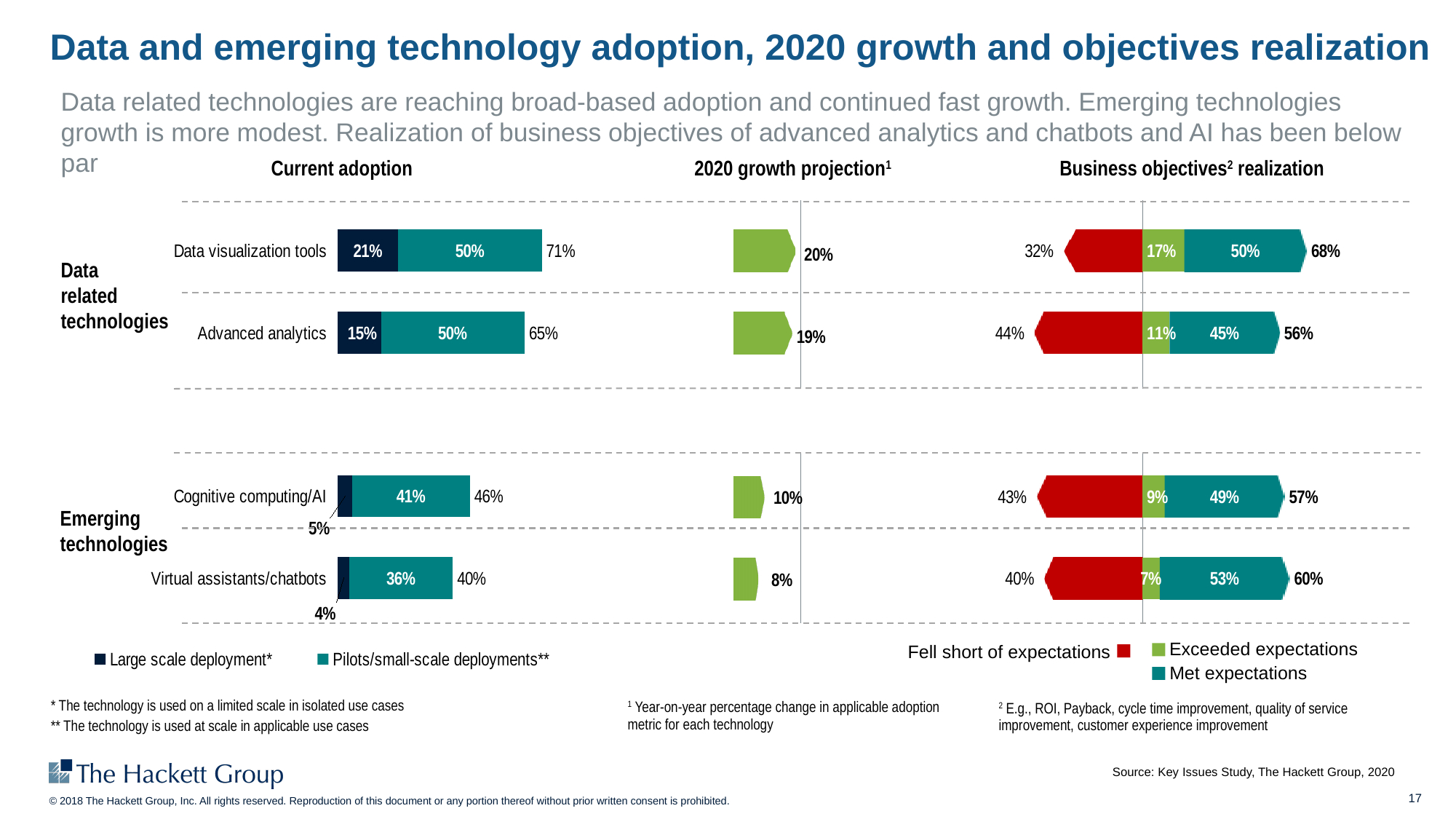
In the Current adoption chart, what is the difference between the total adoption of Data visualization tools and Cognitive computing/AI? 25% In the 2020 growth projection chart, which technology has the highest growth projection? Data visualization tools In the Current adoption chart, what is the large scale deployment value for Data visualization tools? 21% How many series does the legend of the Business objectives realization chart list? 3 In the Current adoption chart, which technology has the lowest total adoption? Virtual assistants/chatbots In the 2020 growth projection chart, what is the value for Advanced analytics? 19% In the Business objectives realization chart, what percentage exceeded expectations for Virtual assistants/chatbots? 7% In the Current adoption chart, what is the total adoption for Advanced analytics? 65% In the 2020 growth projection chart, which is larger: the value for Cognitive computing/AI or Virtual assistants/chatbots? Cognitive computing/AI How many technologies are shown in the Current adoption chart? 4 In the Business objectives realization chart, what percentage fell short of expectations for Advanced analytics? 44% In the Business objectives realization chart, which technology has the highest combined met-plus-exceeded expectations value? Data visualization tools